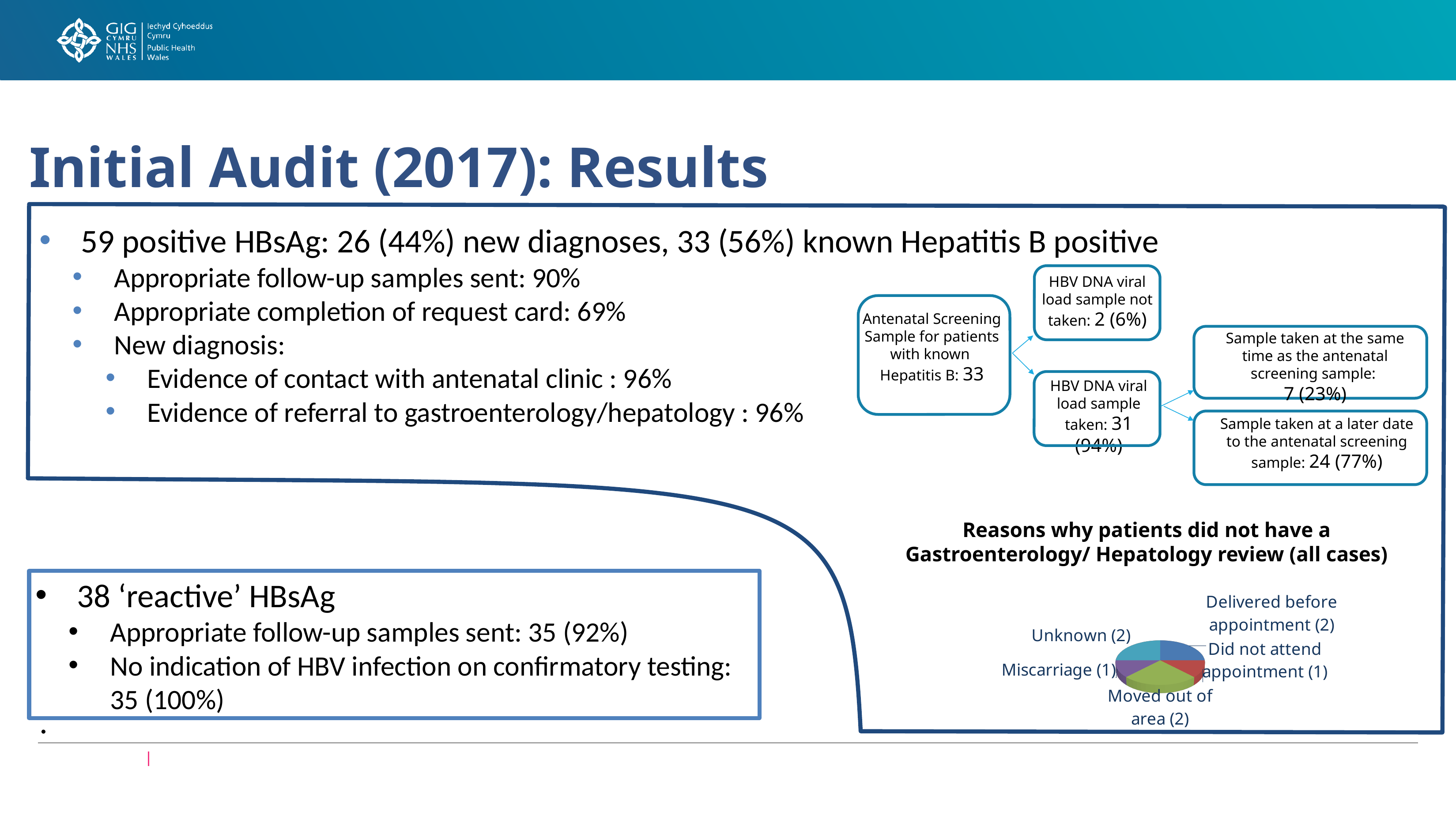
In the pie chart, what share of all cases does 'Delivered before appointment' represent? 25% In the pie chart, what is the difference between the 'Moved out of area' count and the 'Did not attend appointment' count? 1 How many categories does the pie chart of reasons for no Gastroenterology/Hepatology review show? 5 What is the total number of patients represented in the pie chart of reasons for no Gastroenterology/Hepatology review? 8 In the pie chart, how many patients 'Moved out of area'? 2 In the pie chart, which is larger: 'Unknown' or 'Miscarriage'? Unknown In the pie chart, how many patients are in the 'Miscarriage' category? 1 In the pie chart, how many patients 'Delivered before appointment'? 2 What is the title of the pie chart on the slide? Reasons why patients did not have a Gastroenterology/ Hepatology review (all cases) In the pie chart, how many patients are in the 'Unknown' category? 2 In the pie chart, how many patients 'Did not attend appointment'? 1 What kind of chart is shown under the heading 'Reasons why patients did not have a Gastroenterology/ Hepatology review (all cases)'? Pie chart